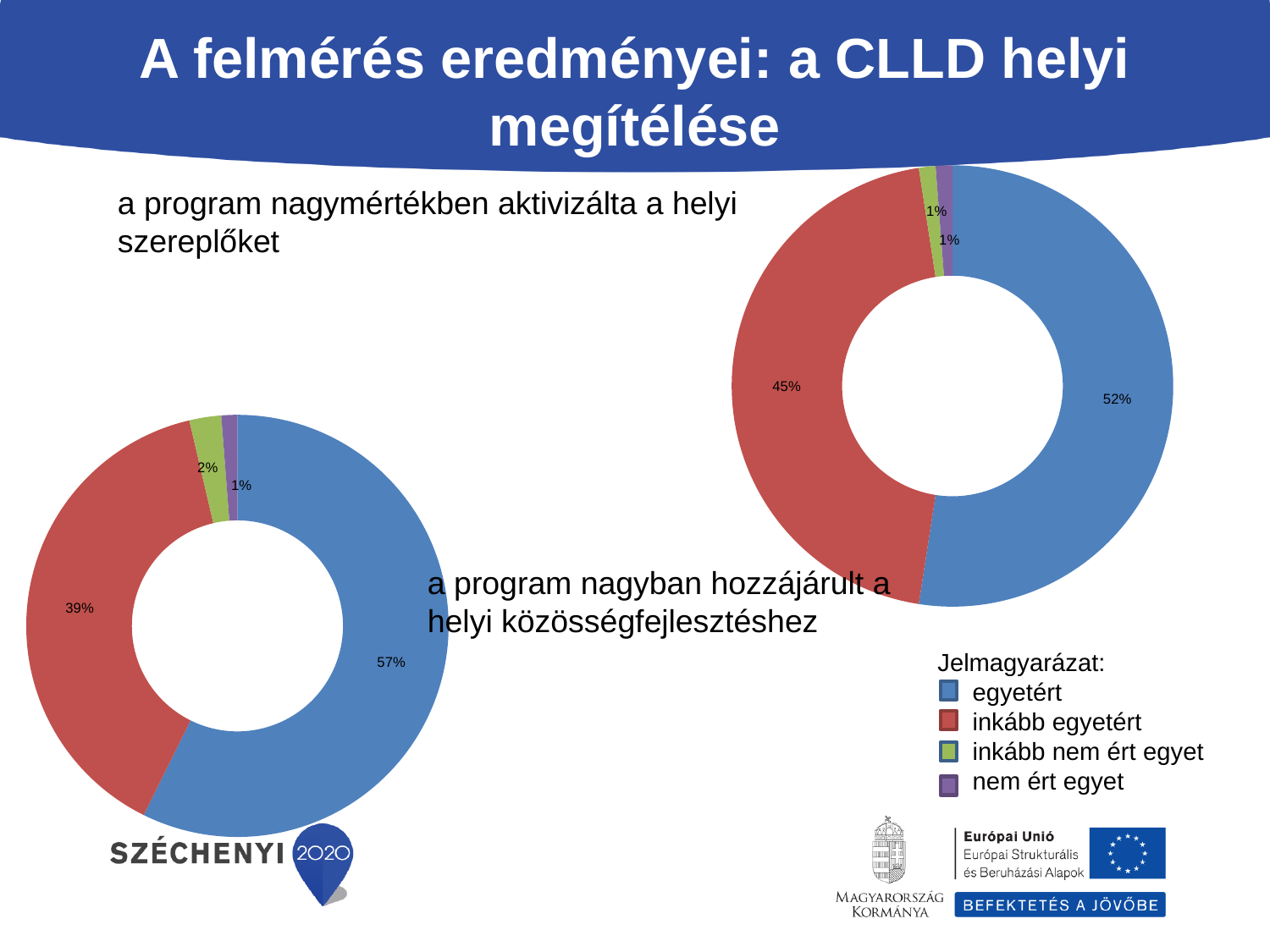
What kind of chart is used on this slide? pie (doughnut) chart In the chart for 'a program nagyban hozzájárult a helyi közösségfejlesztéshez' (right), what share is labelled for 'egyetért'? 52% In the right chart ('a program nagyban hozzájárult a helyi közösségfejlesztéshez'), what is the difference between the 'egyetért' and 'inkább egyetért' shares? 7% In the left chart ('a program nagymértékben aktivizálta a helyi szereplőket'), which category has the smallest share? nem ért egyet In the left chart ('a program nagymértékben aktivizálta a helyi szereplőket'), what is the difference between the 'egyetért' and 'inkább egyetért' shares? 18% In the left chart ('a program nagymértékben aktivizálta a helyi szereplőket'), which category has the largest share? egyetért How many entries does the legend (Jelmagyarázat) list? 4 In the chart for 'a program nagyban hozzájárult a helyi közösségfejlesztéshez' (right), what share is labelled for 'inkább egyetért'? 45% Which chart has the larger 'egyetért' share: the left one ('a program nagymértékben aktivizálta a helyi szereplőket') or the right one ('a program nagyban hozzájárult a helyi közösségfejlesztéshez')? the left one In the right chart ('a program nagyban hozzájárult a helyi közösségfejlesztéshez'), which category has the largest share? egyetért In the chart for 'a program nagymértékben aktivizálta a helyi szereplőket' (left), what share is labelled for 'egyetért'? 57% In the chart for 'a program nagymértékben aktivizálta a helyi szereplőket' (left), what share is labelled for 'inkább egyetért'? 39%